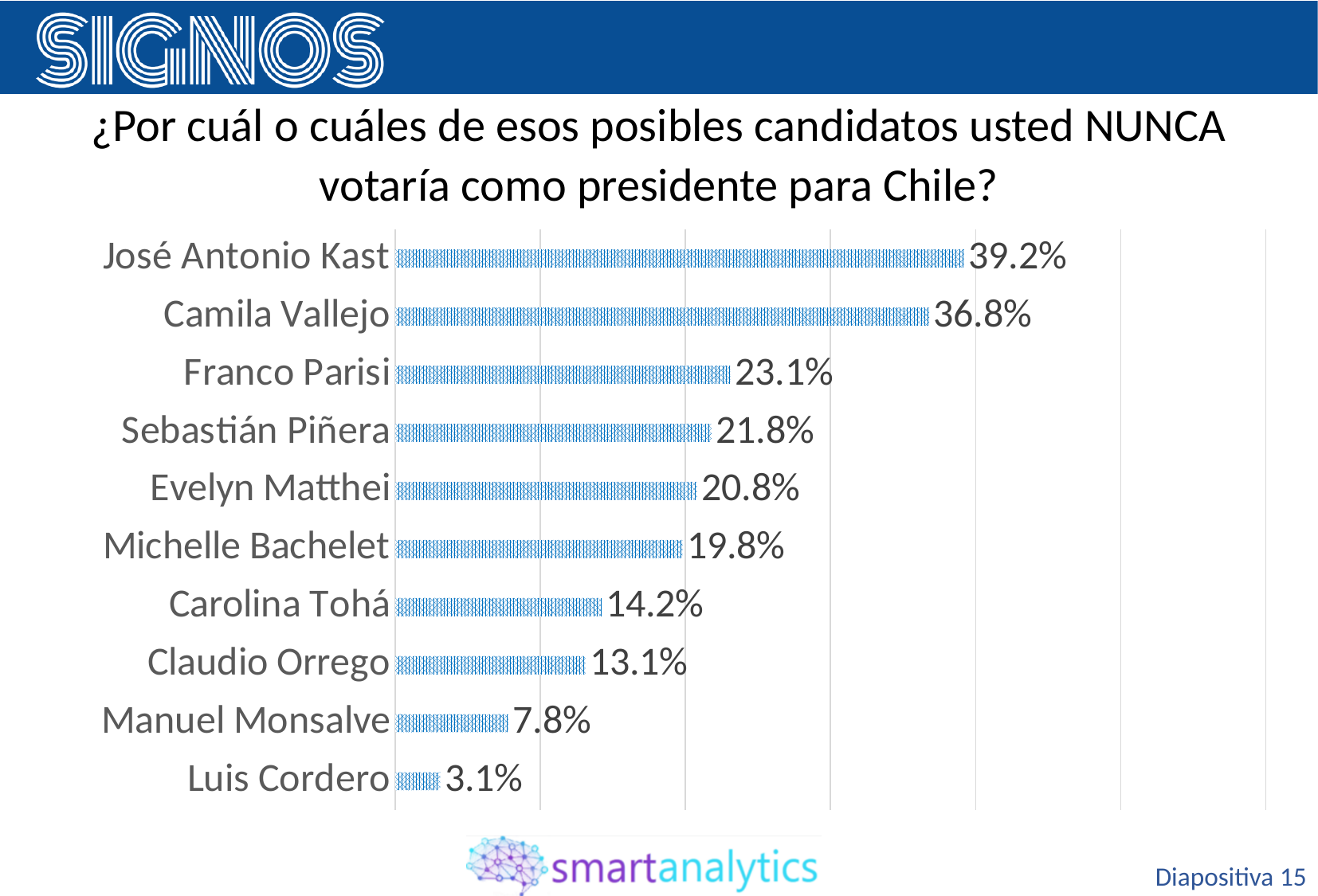
What is the value for Michelle Bachelet? 19.8% Which is larger, the value for Carolina Tohá or the value for Claudio Orrego? Carolina Tohá Which candidate has the lowest value? Luis Cordero Which is larger, the value for Sebastián Piñera or the value for Evelyn Matthei? Sebastián Piñera What is the value for Manuel Monsalve? 7.8% What is the difference between the values for Franco Parisi and Claudio Orrego? 10.0% How many candidates are shown in the chart? 10 What is the value for José Antonio Kast? 39.2% What is the difference between the values for José Antonio Kast and Camila Vallejo? 2.4% Which candidate has the highest value? José Antonio Kast What is the title of the chart? ¿Por cuál o cuáles de esos posibles candidatos usted NUNCA votaría como presidente para Chile? What kind of chart is shown on the slide? Bar chart